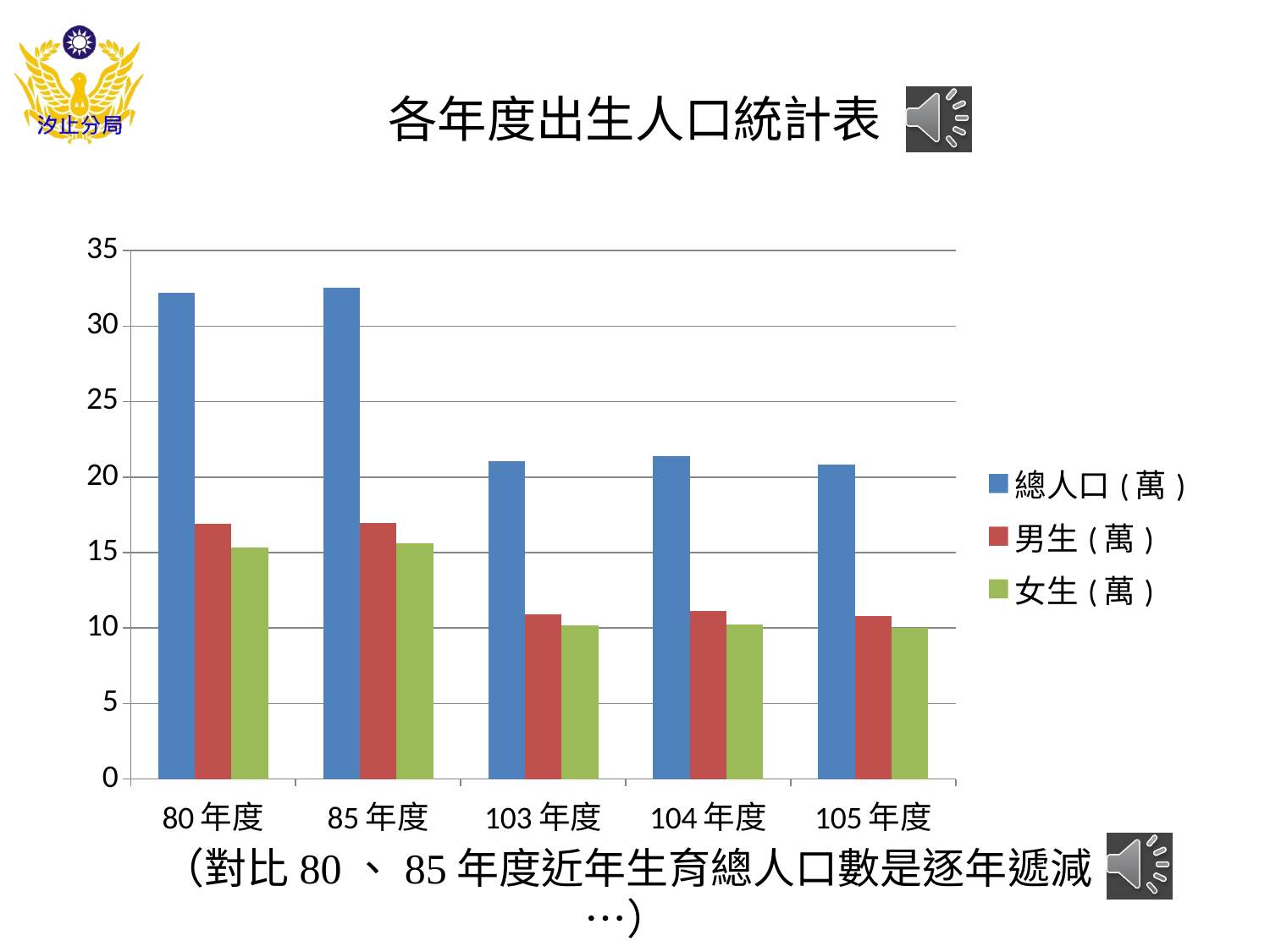
Which series is shown in blue? 總人口（萬） Is the value of 男生（萬） for 80 年度 greater or less than 15? greater In 85 年度, which is larger, 男生（萬） or 女生（萬）? 男生（萬） Which is larger, 總人口（萬） for 80 年度 or 總人口（萬） for 105 年度? 80 年度 How many year categories are shown on the x axis? 5 Is the value of 男生（萬） for 103 年度 greater or less than 15? less What is the title of the chart? 各年度出生人口統計表 Is the value of 女生（萬） for 85 年度 greater or less than 15? greater How many series does the legend list? 3 What kind of chart is shown on the slide? bar chart